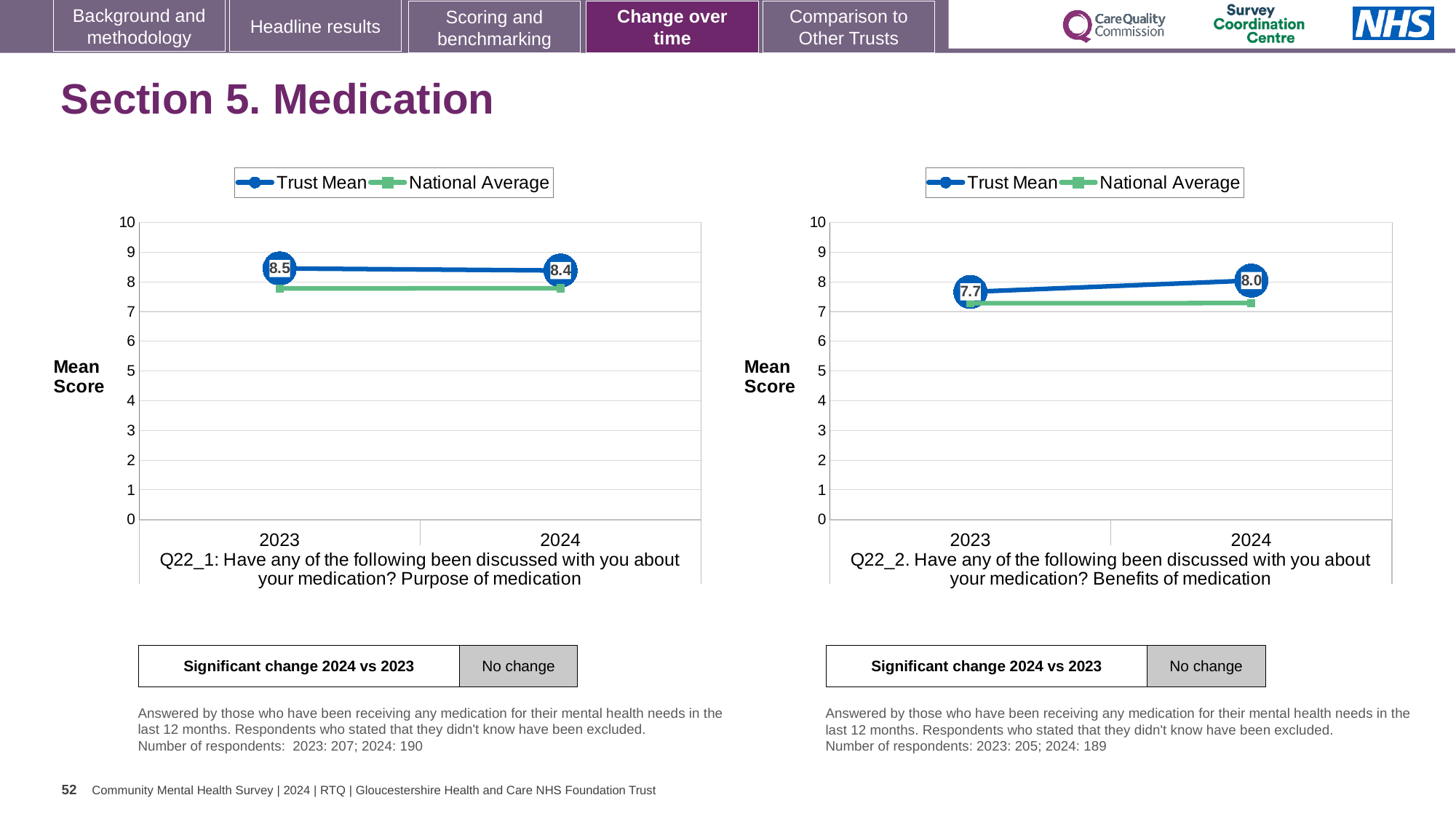
How many series does the legend of the left chart (Q22_1: Purpose of medication) list? 2 On the left chart (Q22_1: Purpose of medication), what is the Trust Mean score for 2024? 8.4 On the left chart (Q22_1: Purpose of medication), what is the difference between the Trust Mean in 2023 and 2024? 0.1 On the right chart (Q22_2: Benefits of medication), does the Trust Mean rise or fall from 2023 to 2024? rise On the left chart (Q22_1: Purpose of medication), what is the Trust Mean score for 2023? 8.5 On the right chart (Q22_2: Benefits of medication), what is the Trust Mean score for 2023? 7.7 What kind of chart is the right chart (Q22_2: Benefits of medication)? line chart On the right chart (Q22_2: Benefits of medication), is the National Average for 2023 greater or less than 8? less On the left chart (Q22_1: Purpose of medication), is the National Average for 2024 greater or less than 8? less On the right chart (Q22_2: Benefits of medication), what is the Trust Mean score for 2024? 8.0 On the right chart (Q22_2: Benefits of medication), by how much did the Trust Mean change from 2023 to 2024? 0.3 On the right chart (Q22_2: Benefits of medication), which is larger in 2024, the Trust Mean or the National Average? Trust Mean